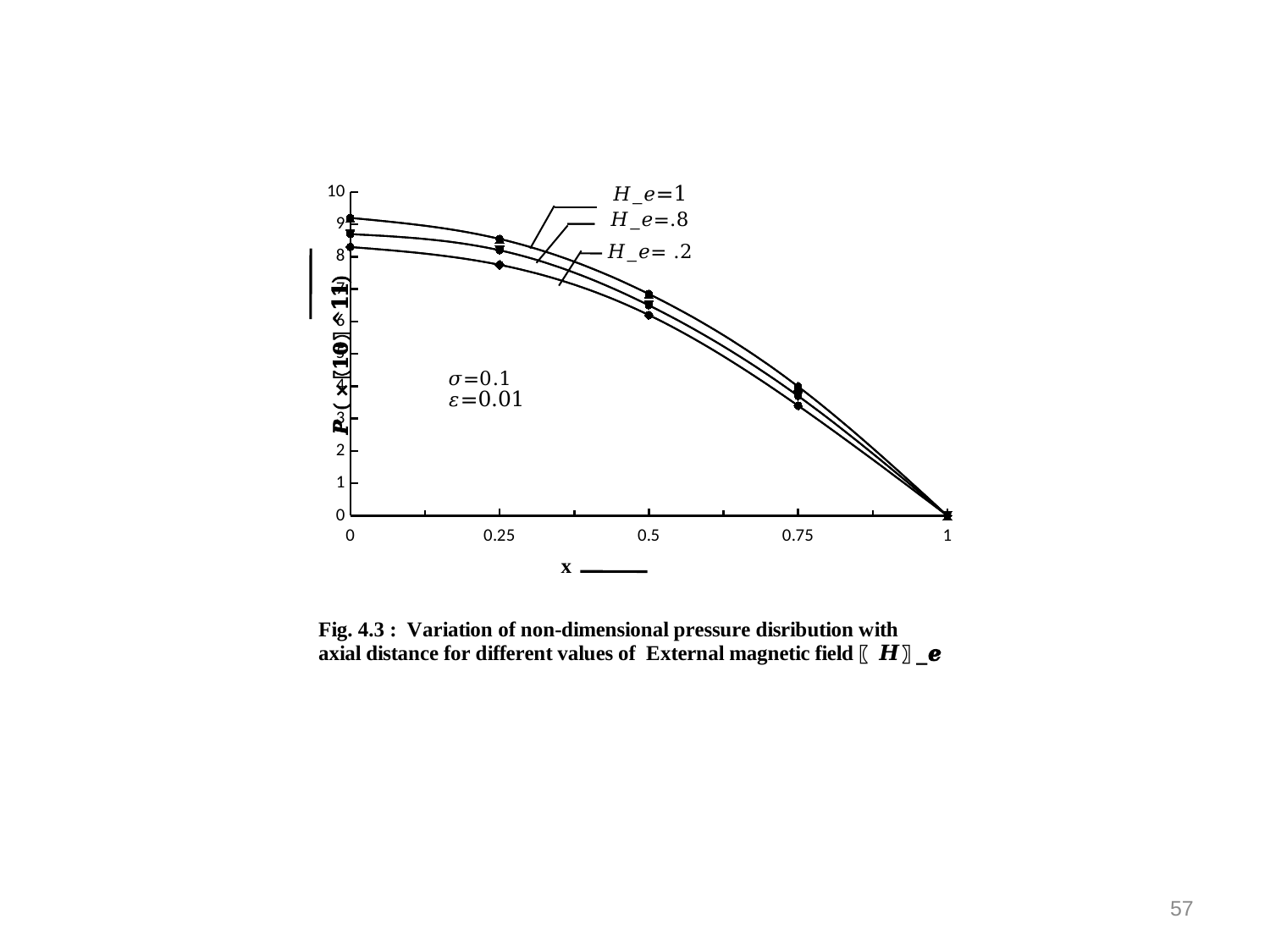
What is the value of all three curves at x = 1? 0 What values of σ and ε are stated on the chart? σ=0.1, ε=0.01 Is the value of the H_e=.2 curve at x = 0 greater or less than 9? less Which curve has the lowest values across the chart (excluding x = 1 where all meet)? H_e=.2 Is the value of the H_e=1 curve at x = 0 greater or less than 9? greater How many series (curves) are plotted on the chart? 3 Is the value of the H_e=1 curve at x = 0.75 greater or less than 3? greater How many x-axis tick values are shown on the chart? 5 What kind of chart is shown on the slide? line chart At x = 0, which curve has the higher value: H_e=1 or H_e=.2? H_e=1 Do the plotted values rise or fall as x increases from 0 to 1? fall